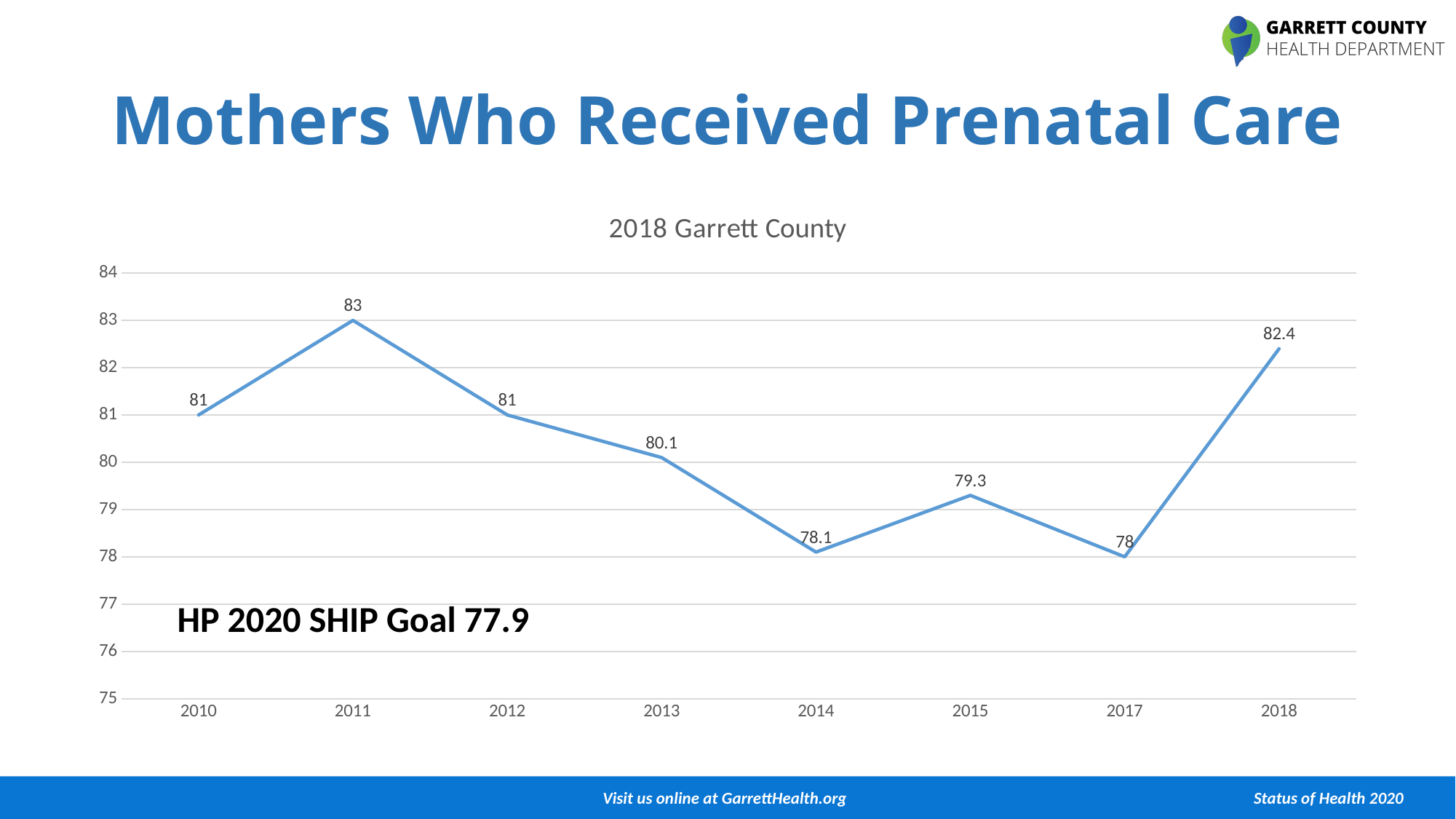
How many years are plotted on the chart? 8 What is the difference between the values for 2018 and 2014? 4.3 What is the chart's title? 2018 Garrett County What is the value for 2011? 83 What is the difference between the values for 2011 and 2017? 5 What is the value for 2014? 78.1 Which year has the lowest value? 2017 What is the value for 2018? 82.4 What kind of chart is shown? line chart Which is larger, the value for 2013 or the value for 2015? 2013 Do the values rise or fall from 2011 to 2014? fall Which year has the highest value? 2011